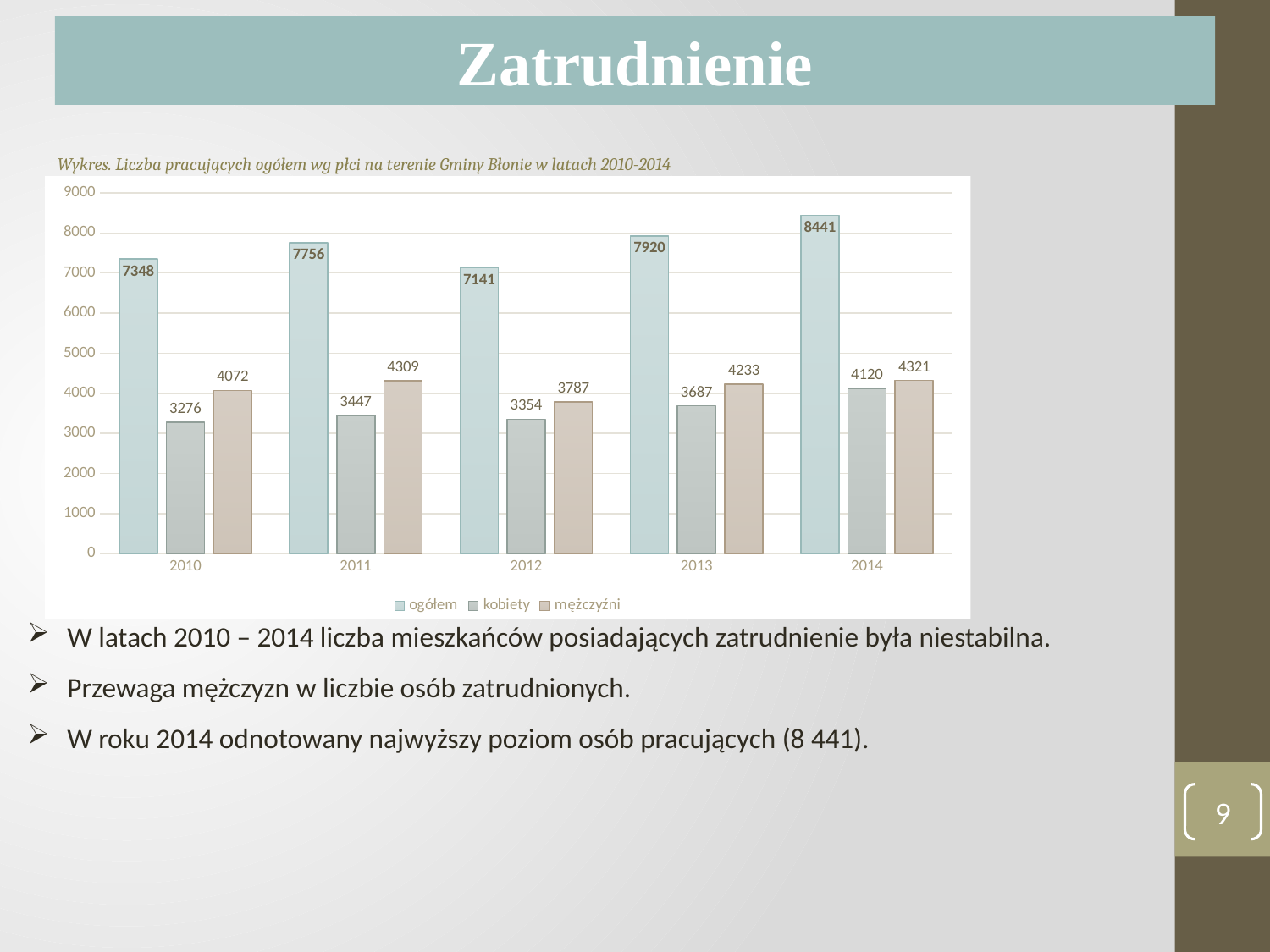
What is the value of 'ogółem' for 2014? 8441 What is the value of 'kobiety' for 2011? 3447 What kind of chart is shown on the slide? bar chart How many years are shown on the x axis? 5 What is the value of 'mężczyźni' for 2012? 3787 Which is larger in 2010: 'kobiety' or 'mężczyźni'? mężczyźni What is the difference between 'mężczyźni' and 'kobiety' in 2013? 546 Which year has the lowest 'kobiety' value? 2010 Is the 'ogółem' value for 2012 greater or less than 7000? greater What are the three series listed in the legend? ogółem, kobiety, mężczyźni Which year has the highest 'ogółem' value? 2014 How many series does the legend list? 3